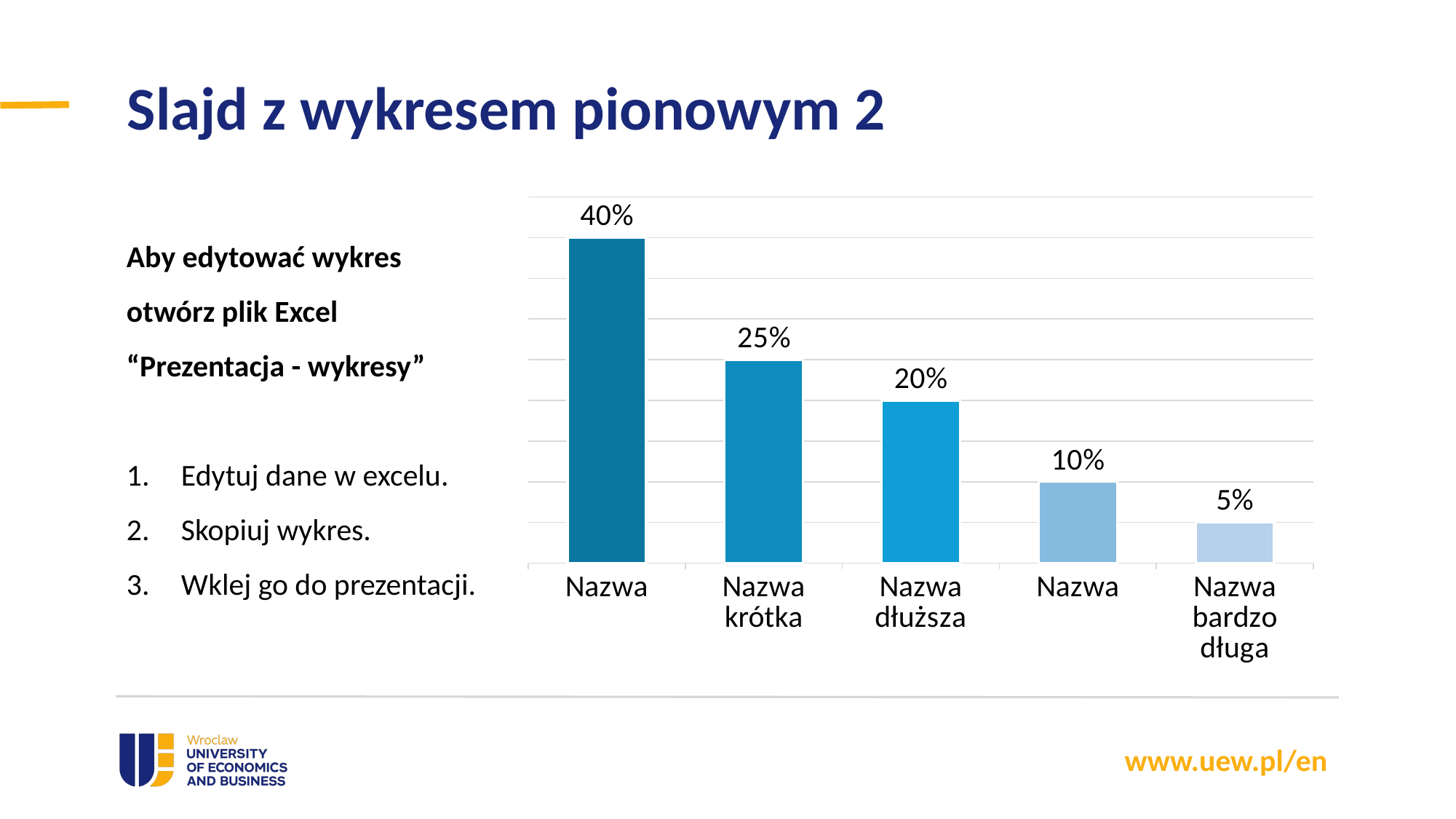
What is the value of the first (leftmost) bar? 40% What is the value of the bar labelled "Nazwa bardzo długa"? 5% What is the value of the fourth bar from the left? 10% Which category has the lowest value? Nazwa bardzo długa What kind of chart is shown on the slide? Bar chart What is the difference between the first bar and the last bar? 35% What is the value of the bar labelled "Nazwa krótka"? 25% How many bars are in the chart? 5 What is the value of the bar labelled "Nazwa dłuższa"? 20% What is the highest value shown in the chart? 40% What is the difference between the values for "Nazwa krótka" and "Nazwa dłuższa"? 5% Which is larger, the value for "Nazwa krótka" or the value for "Nazwa bardzo długa"? Nazwa krótka